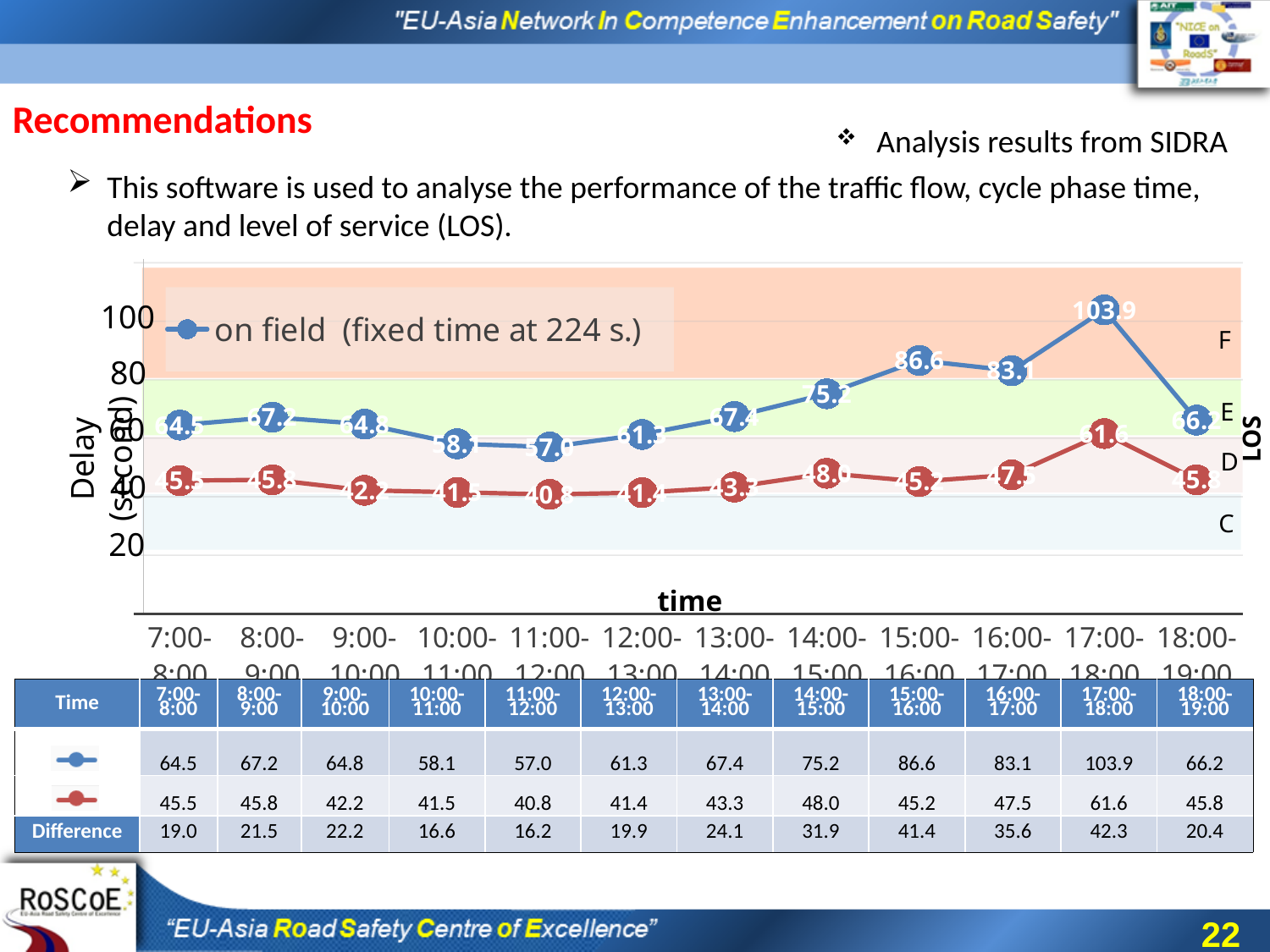
What is the difference between the blue and red series in the 15:00-16:00 interval? 41.4 What is the delay for the blue 'on field' series in the 17:00-18:00 interval? 103.9 Does the blue 'on field' series rise or fall from 9:00-10:00 to 11:00-12:00? fall In which time interval is the blue 'on field' series at its lowest value? 11:00-12:00 Is the blue 'on field' value for 17:00-18:00 greater or less than 100? greater What is the legend entry shown for the blue series? on field (fixed time at 224 s.) For the blue 'on field' series, which is larger: the value at 14:00-15:00 or at 15:00-16:00? 15:00-16:00 In which time interval does the red series reach its highest value? 17:00-18:00 How many time intervals are plotted along the x axis? 12 What is the value of the red series in the 11:00-12:00 interval? 40.8 What kind of chart is shown on the slide? line chart In which time interval does the blue 'on field' series reach its highest value? 17:00-18:00